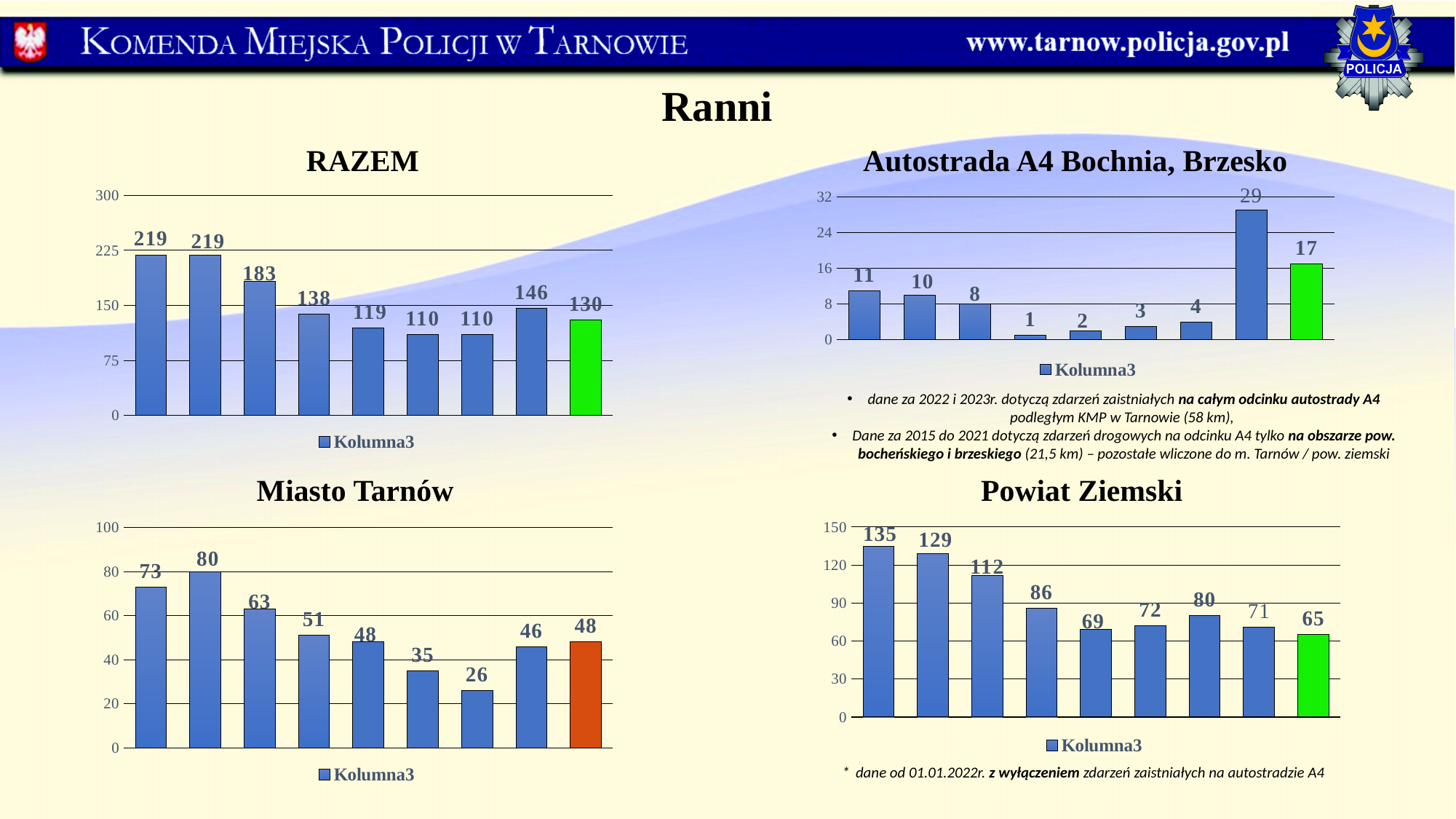
On the Powiat Ziemski chart, what is the value of the third bar? 112 On the Miasto Tarnów chart, which is larger, the first bar or the second bar? the second bar (80) On the Miasto Tarnów chart, what is the lowest value shown? 26 On the Powiat Ziemski chart, what is the difference between the first bar and the last (green) bar? 70 On the RAZEM chart, what is the value of the last (green) bar? 130 On the Autostrada A4 Bochnia, Brzesko chart, what is the highest value shown? 29 On the Autostrada A4 Bochnia, Brzesko chart, what is the lowest value shown? 1 What kind of chart is the RAZEM chart? bar chart What is the legend entry shown under the Powiat Ziemski chart? Kolumna3 How many bars are plotted on the Powiat Ziemski chart? 9 On the Autostrada A4 Bochnia, Brzesko chart, what is the difference between the eighth bar and the last (green) bar? 12 On the RAZEM chart, what is the highest value shown? 219